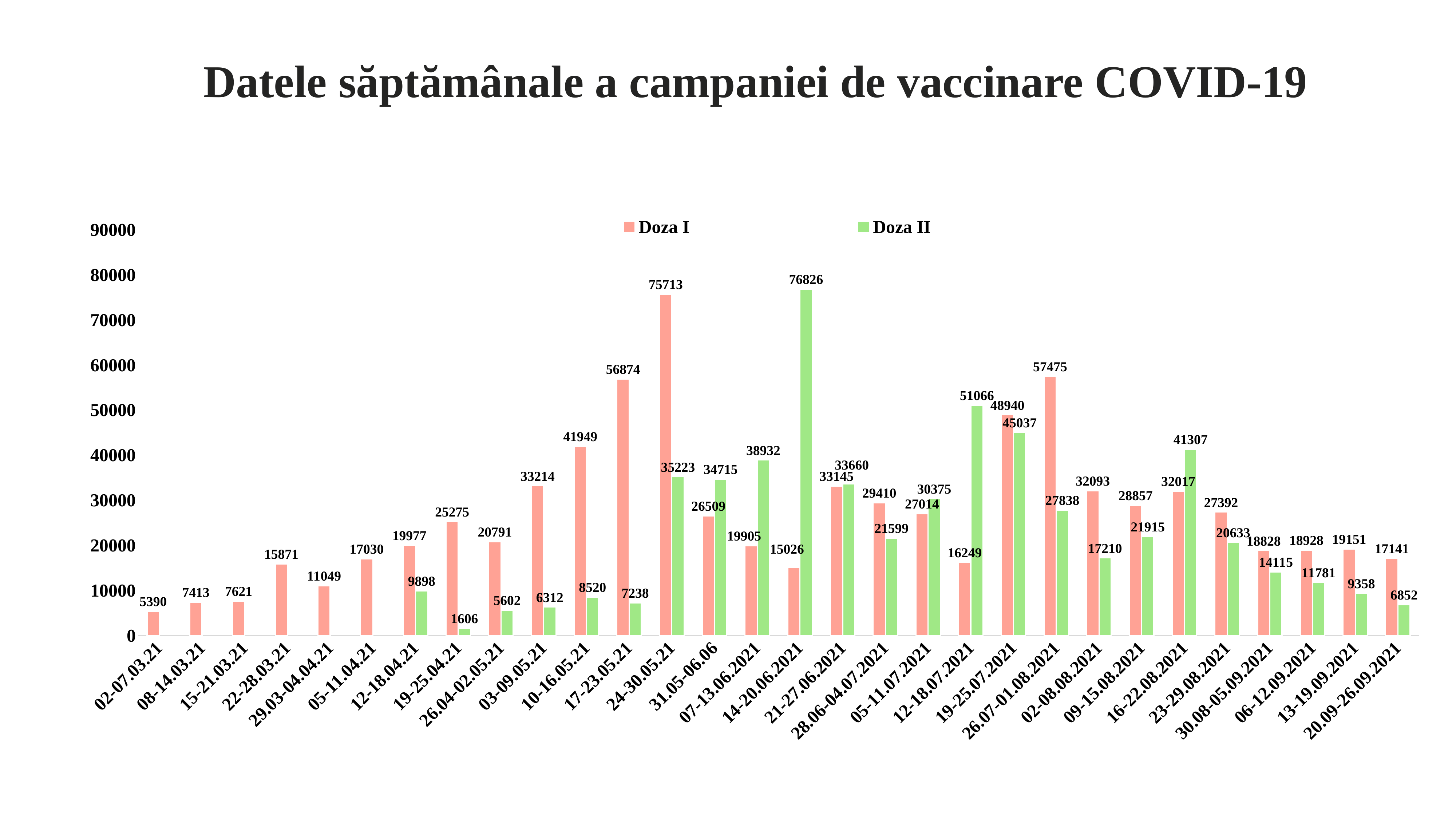
Which week has the highest Doza II value? 14-20.06.2021 What is the Doza II value for the week 14-20.06.2021? 76826 Which week has the lowest Doza II value among the weeks where Doza II is shown? 19-25.04.21 Which week has the lowest Doza I value? 02-07.03.21 What colour represents Doza II in the legend? Green Which week has the highest Doza I value? 24-30.05.21 In the week 12-18.07.2021, which is larger, Doza I or Doza II? Doza II What is the Doza I value for the week 24-30.05.21? 75713 What is the difference between Doza I and Doza II in the week 24-30.05.21? 40490 What is the Doza II value for the week 16-22.08.2021? 41307 How many series does the legend list? 2 What kind of chart is shown on the slide? Bar chart